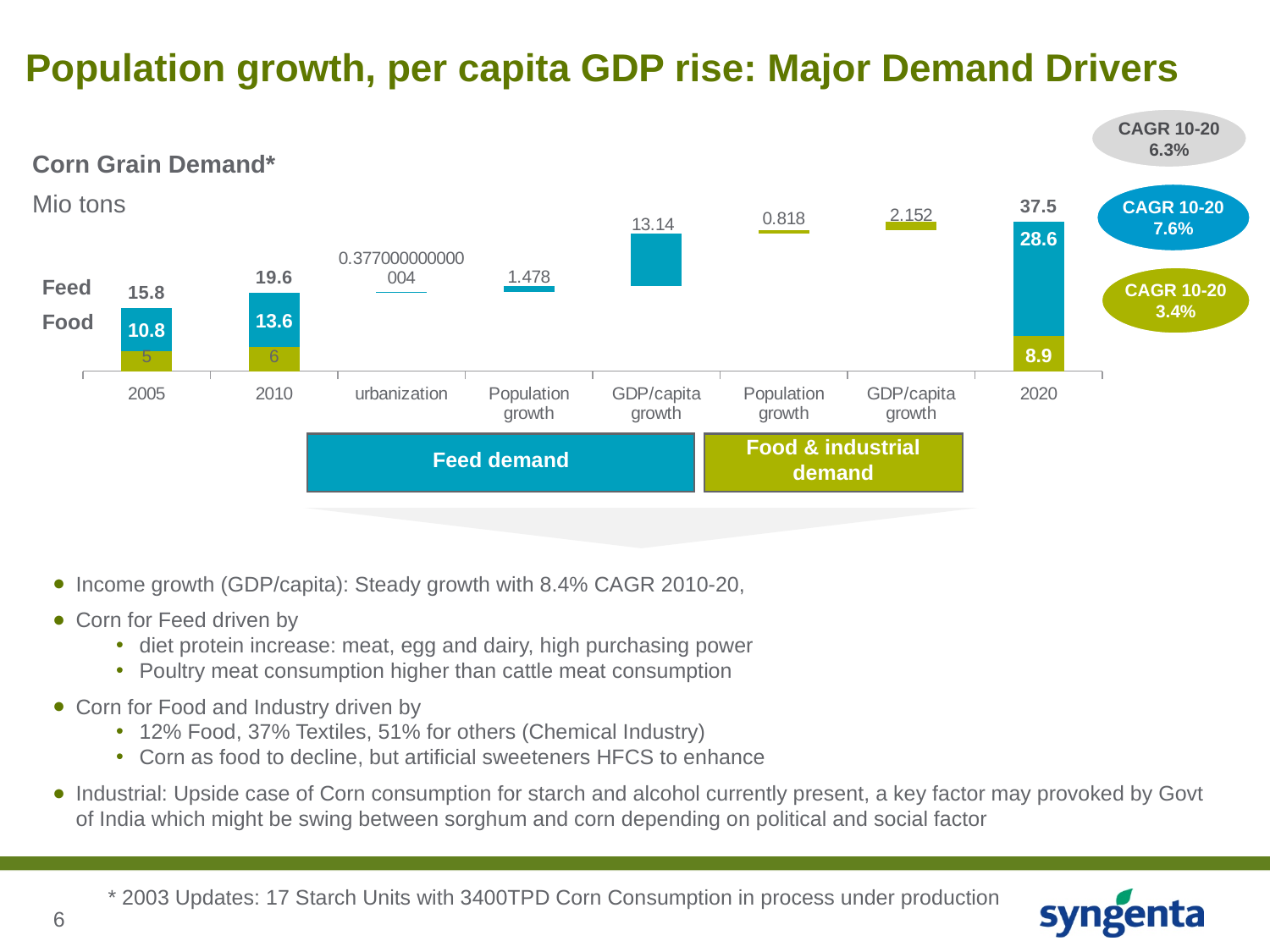
What is the value of the Population growth step under Food & industrial demand? 0.818 How many categories are shown along the x axis of the chart? 8 What is the difference between the Feed values for 2020 and 2005? 17.8 What is the Food value for 2020? 8.9 What is the Food value for 2005? 5 What kind of chart is used to show Corn Grain Demand? Bar chart What is the value of the GDP/capita growth step under Feed demand? 13.14 By how much does the total corn grain demand increase from 2010 to 2020? 17.9 Which is larger: the GDP/capita growth step under Feed demand or the GDP/capita growth step under Food & industrial demand? GDP/capita growth under Feed demand Which year has the highest total corn grain demand? 2020 What is the Feed value for 2010? 13.6 What is the total corn grain demand shown for 2020? 37.5